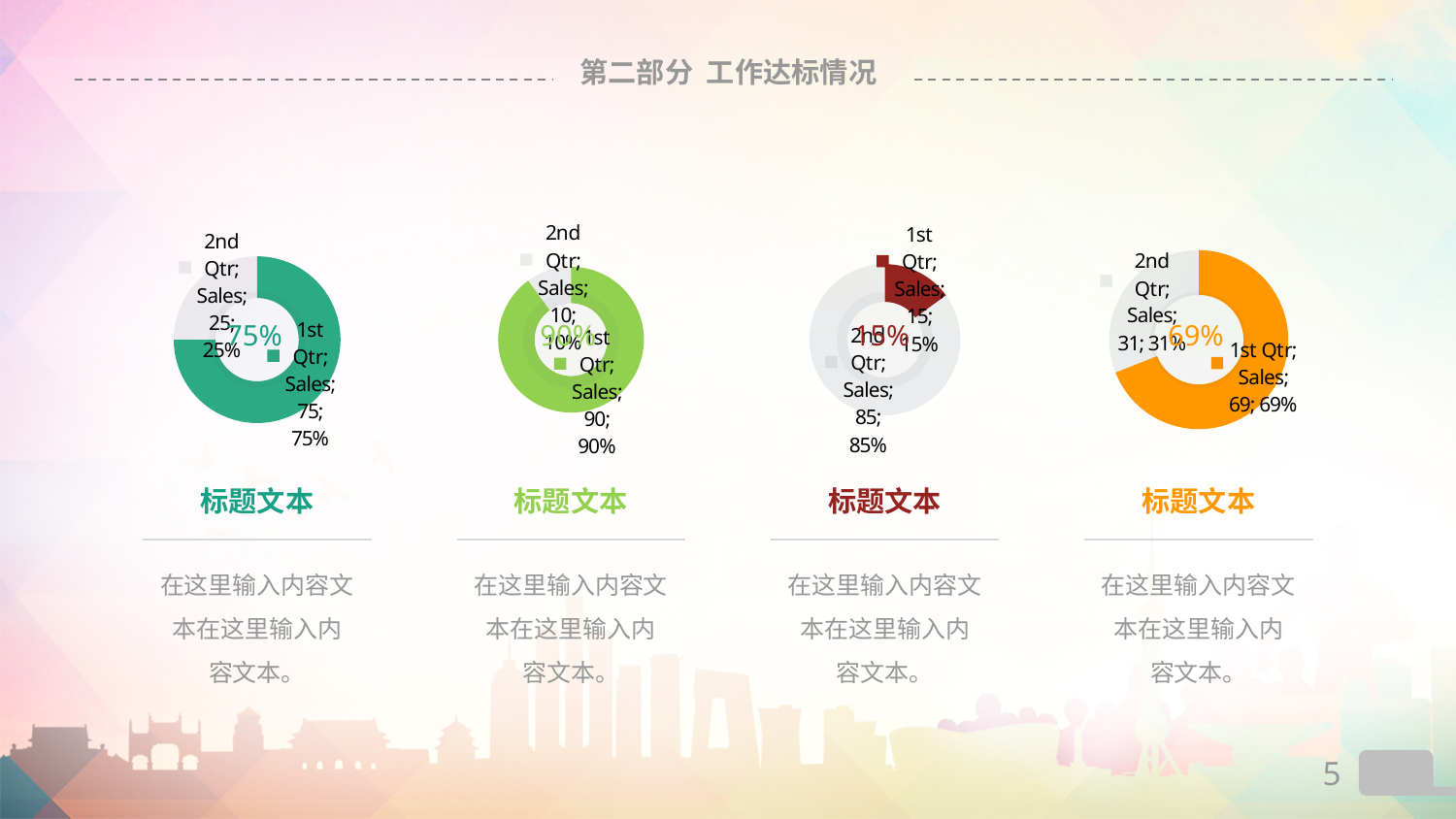
In the third donut chart from the left, what percentage is shown for 2nd Qtr Sales? 85% In the third donut chart from the left, which category has the smaller value? 1st Qtr In the second donut chart from the left, what percentage is shown for 1st Qtr Sales? 90% In the rightmost donut chart, what is the difference between the 1st Qtr and 2nd Qtr Sales values? 38 In the leftmost donut chart, which category is larger, 1st Qtr or 2nd Qtr? 1st Qtr How many categories does the second donut chart from the left show? 2 In the second donut chart from the left, what is the value shown for 2nd Qtr Sales? 10 What type of chart is the rightmost chart on the slide? Donut chart What percentage is printed in the center of the third donut chart from the left? 15% In the rightmost donut chart, what is the value shown for 1st Qtr Sales? 69 In the leftmost donut chart, what percentage is shown for 2nd Qtr Sales? 25% In the leftmost donut chart, what is the value shown for 1st Qtr Sales? 75